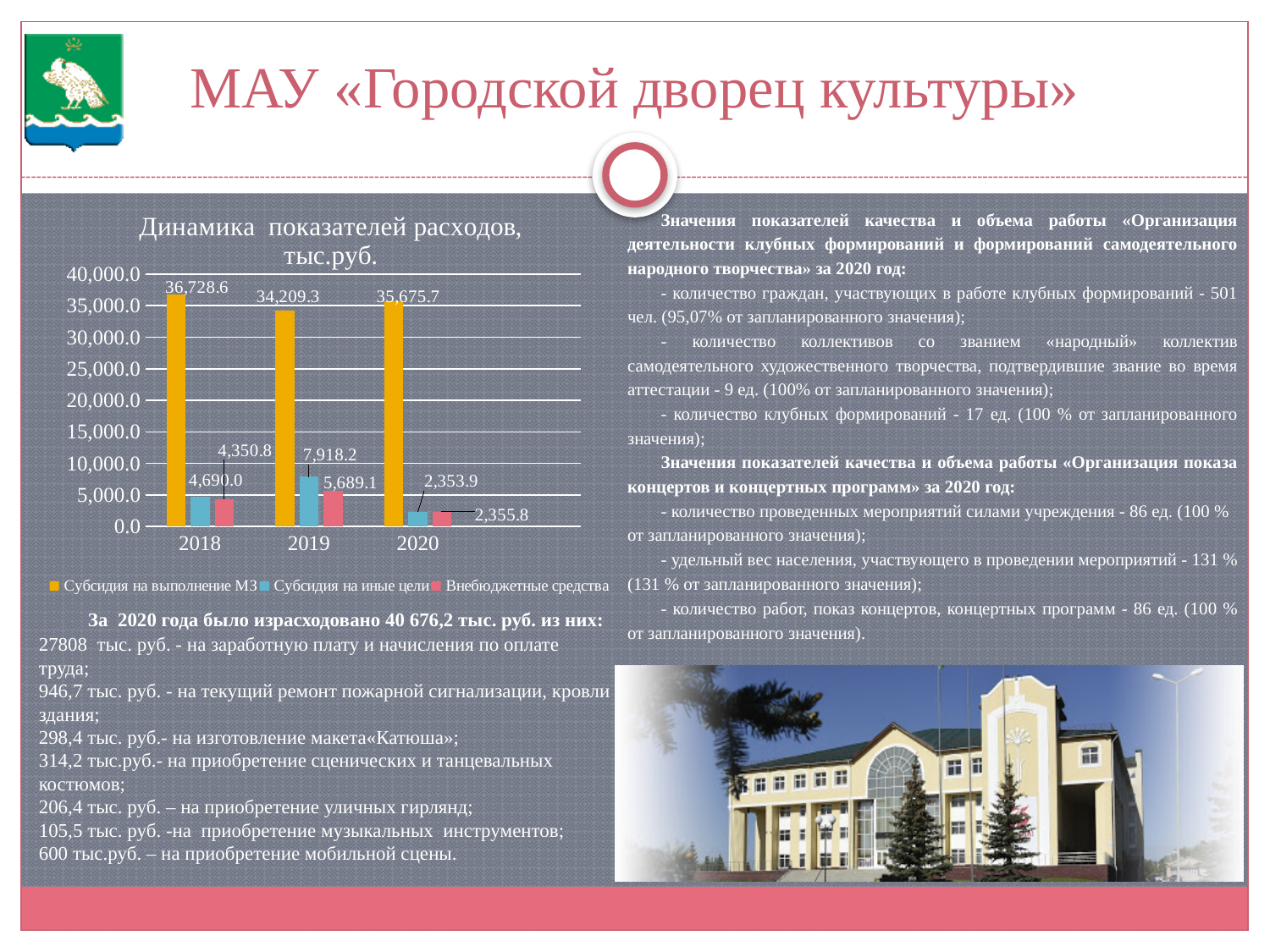
In which year is Субсидия на выполнение МЗ the highest? 2018 What is the value of Внебюджетные средства for 2018? 4,350.8 What is the title of the chart? Динамика показателей расходов, тыс.руб. Which is larger in 2019: Субсидия на иные цели or Внебюджетные средства? Субсидия на иные цели In which year is Субсидия на иные цели the lowest? 2020 What is the value of Субсидия на выполнение МЗ for 2018? 36,728.6 How many years are shown on the x axis of the chart? 3 What type of chart is shown on the slide? bar chart How many series does the chart legend list? 3 What is the value of Субсидия на иные цели for 2019? 7,918.2 What is the value of Субсидия на выполнение МЗ for 2020? 35,675.7 What is the difference between Субсидия на выполнение МЗ in 2018 and in 2019? 2,519.3